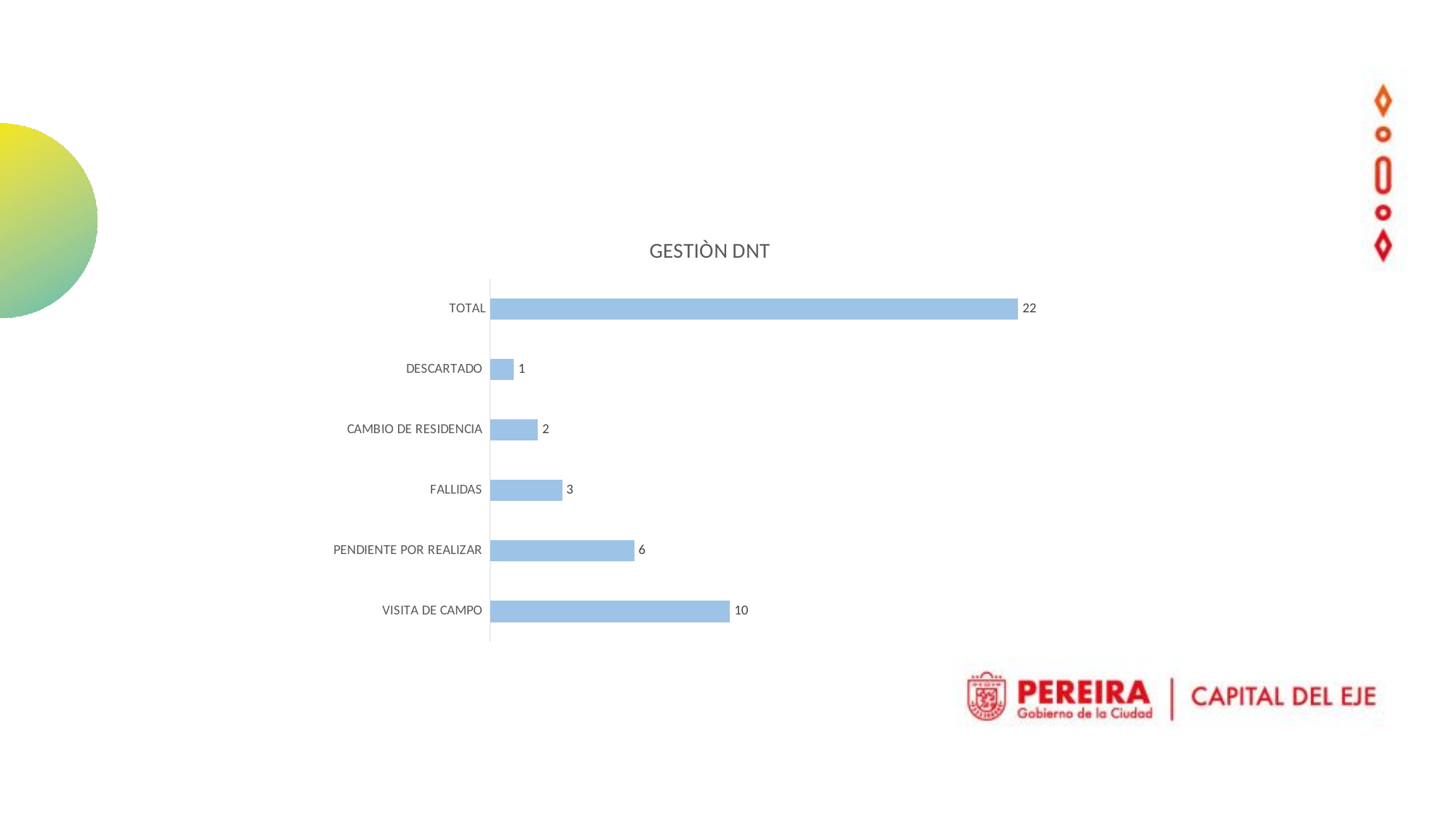
How many categories are shown in the chart? 6 Which category has the lowest value? DESCARTADO What is the difference between the values for TOTAL and VISITA DE CAMPO? 12 Which is larger, the value for FALLIDAS or the value for CAMBIO DE RESIDENCIA? FALLIDAS Which category has the highest value? TOTAL What is the value for PENDIENTE POR REALIZAR? 6 What is the value for FALLIDAS? 3 What is the title of the chart? GESTIÒN DNT What is the value for VISITA DE CAMPO? 10 What kind of chart is shown on the slide? Bar chart What is the difference between the values for VISITA DE CAMPO and PENDIENTE POR REALIZAR? 4 What is the value for DESCARTADO? 1